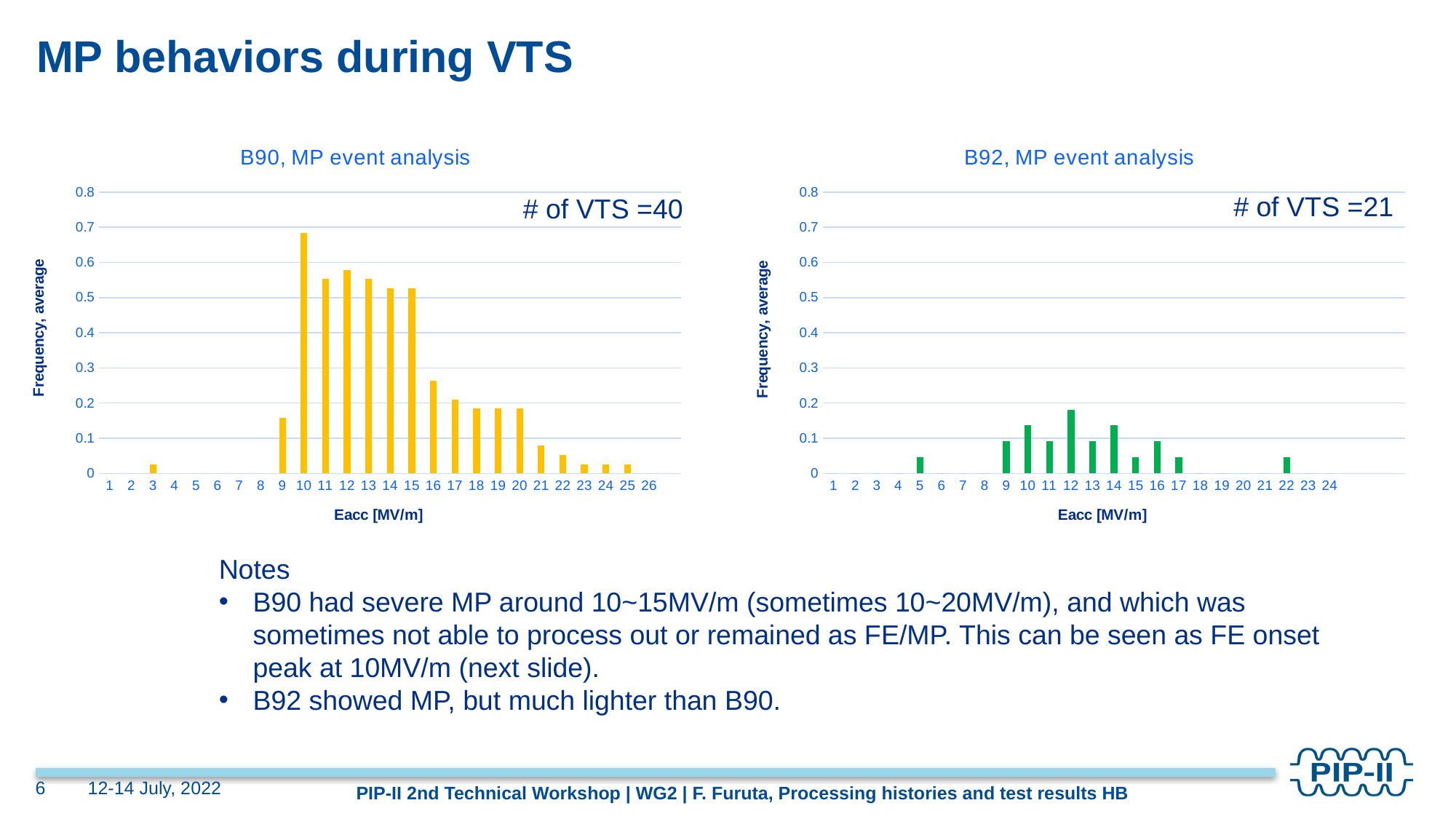
In the B90, MP event analysis chart, is the value at Eacc 10 greater or less than 0.6? greater What type of chart is the B90, MP event analysis chart? bar chart What is the y-axis label of the B92, MP event analysis chart? Frequency, average In the B90, MP event analysis chart, which has the larger value, Eacc 10 or Eacc 16? Eacc 10 In the B90, MP event analysis chart, is the value at Eacc 16 greater or less than 0.3? less In the B92, MP event analysis chart, is the value at Eacc 12 greater or less than 0.2? less In the B92, MP event analysis chart, which has the larger value, Eacc 12 or Eacc 15? Eacc 12 In the B92, MP event analysis chart, at which Eacc value is the frequency highest? 12 What number of VTS is stated on the B90, MP event analysis chart? 40 In the B90, MP event analysis chart, at which Eacc value is the frequency highest? 10 How many Eacc categories are labeled on the x axis of the B92, MP event analysis chart? 24